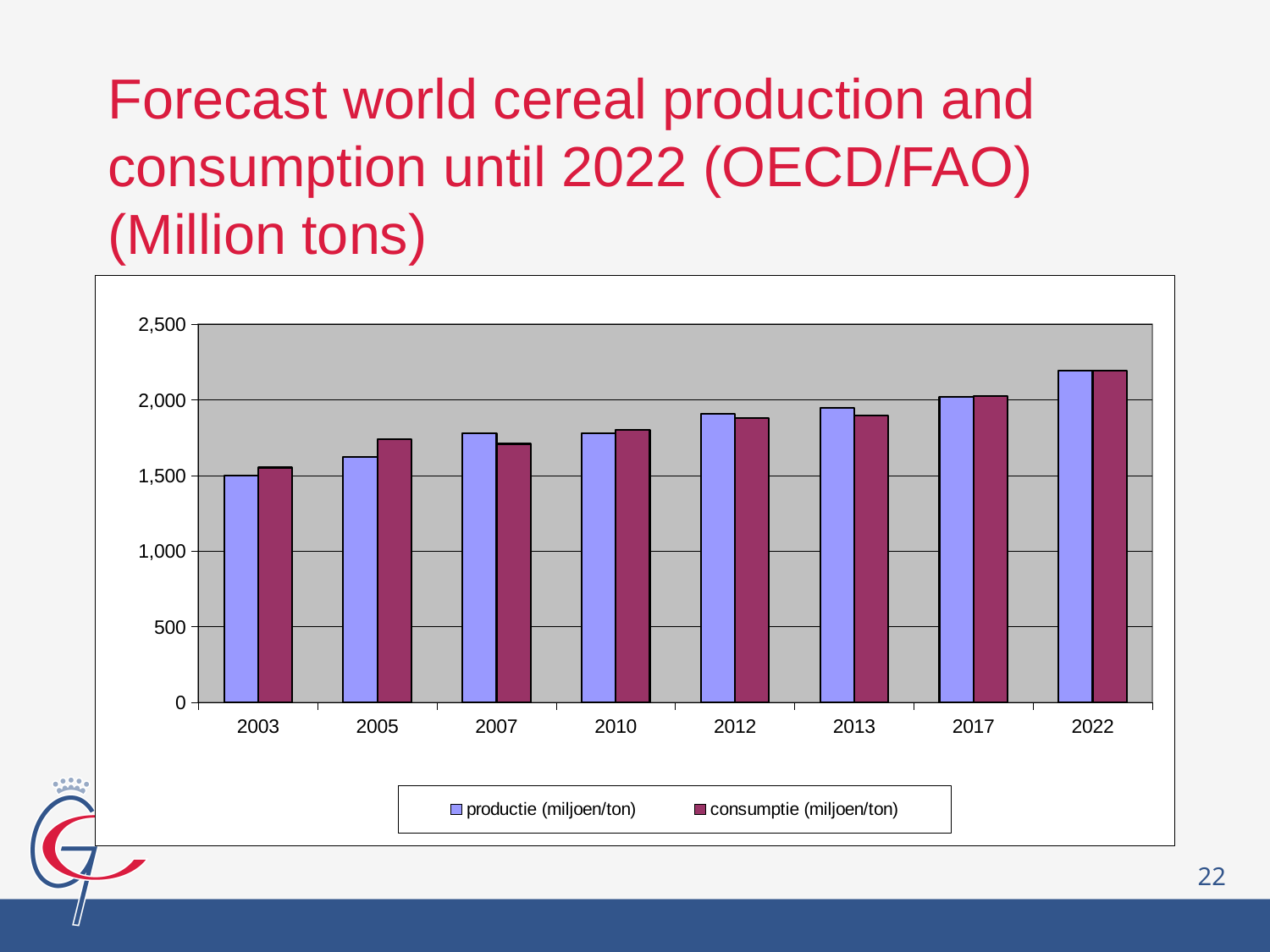
Is the consumptie (miljoen/ton) value for 2003 greater or less than 1,500? greater What are the two series named in the chart legend? productie (miljoen/ton) and consumptie (miljoen/ton) How many years are shown on the x axis of the chart? 8 What kind of chart is shown on the slide? bar chart Which year has the highest productie (miljoen/ton) value? 2022 Which year has the lowest consumptie (miljoen/ton) value? 2003 In 2005, which is larger: productie (miljoen/ton) or consumptie (miljoen/ton)? consumptie (miljoen/ton) Do the productie (miljoen/ton) values generally rise or fall from 2003 to 2022? rise Which year has the lowest productie (miljoen/ton) value? 2003 Is the productie (miljoen/ton) value for 2022 greater or less than 2,000? greater How many series does the chart legend list? 2 Is the consumptie (miljoen/ton) value for 2013 greater or less than 2,000? less